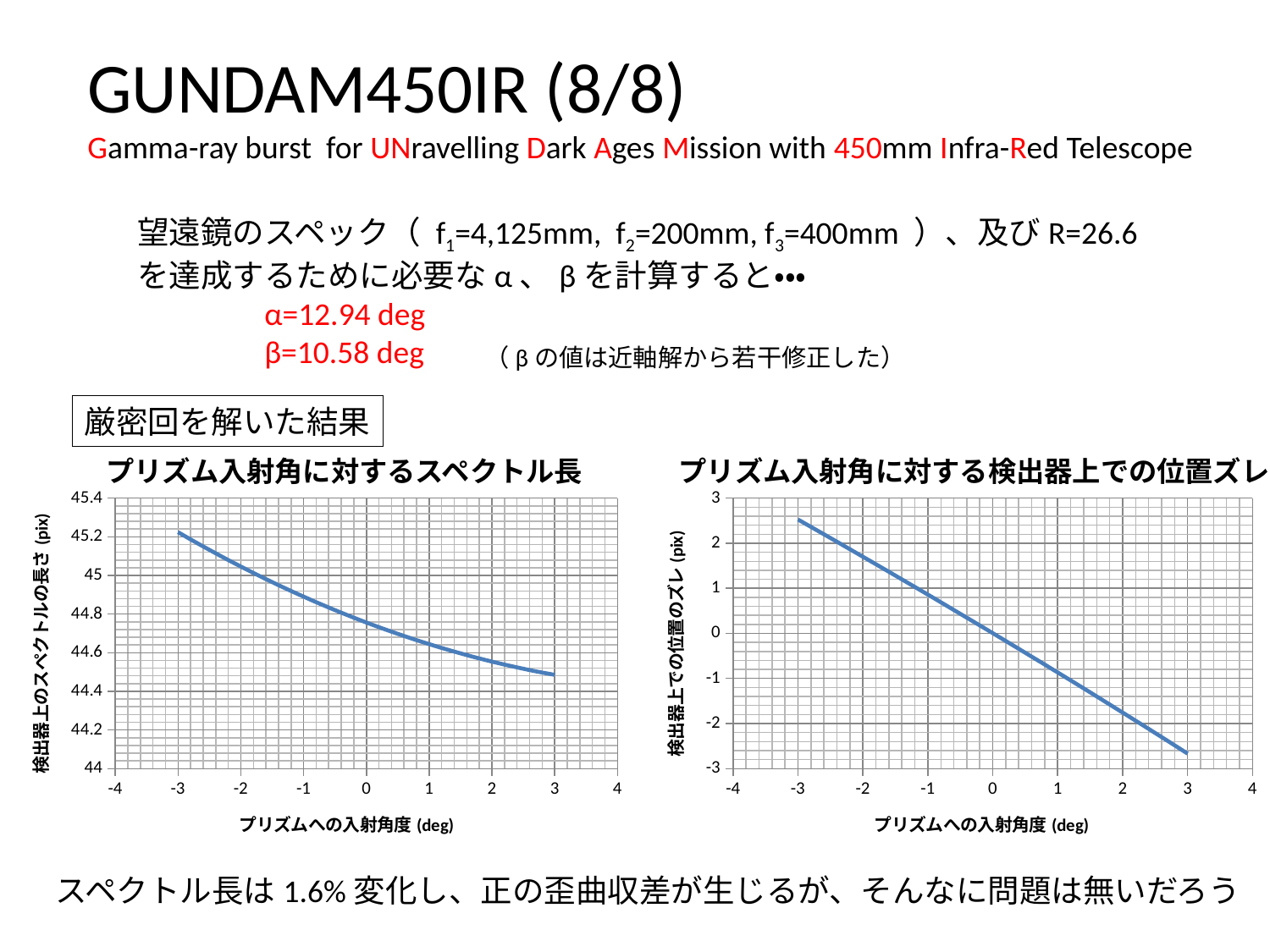
In the left chart 'プリズム入射角に対するスペクトル長', is the value at an incidence angle of 3 greater or less than 44.6? less In the right chart 'プリズム入射角に対する検出器上での位置ズレ', do the values rise or fall as the prism incidence angle increases from -3 to 3? fall In the right chart 'プリズム入射角に対する検出器上での位置ズレ', is the value at an incidence angle of -3 greater or less than 2? greater In the right chart 'プリズム入射角に対する検出器上での位置ズレ', is the value at an incidence angle of 3 greater or less than -2? less What kind of chart is the right chart titled 'プリズム入射角に対する検出器上での位置ズレ'? line chart In the left chart 'プリズム入射角に対するスペクトル長', do the values rise or fall as the prism incidence angle increases from -3 to 3? fall What kind of chart is the left chart titled 'プリズム入射角に対するスペクトル長'? line chart What is the x-axis label of the left chart 'プリズム入射角に対するスペクトル長'? プリズムへの入射角度 (deg) In the right chart 'プリズム入射角に対する検出器上での位置ズレ', which incidence angle has the larger value, -2 or 2? -2 In the left chart 'プリズム入射角に対するスペクトル長', which incidence angle has the larger value, -3 or 3? -3 What is the y-axis label of the right chart 'プリズム入射角に対する検出器上での位置ズレ'? 検出器上での位置のズレ (pix)